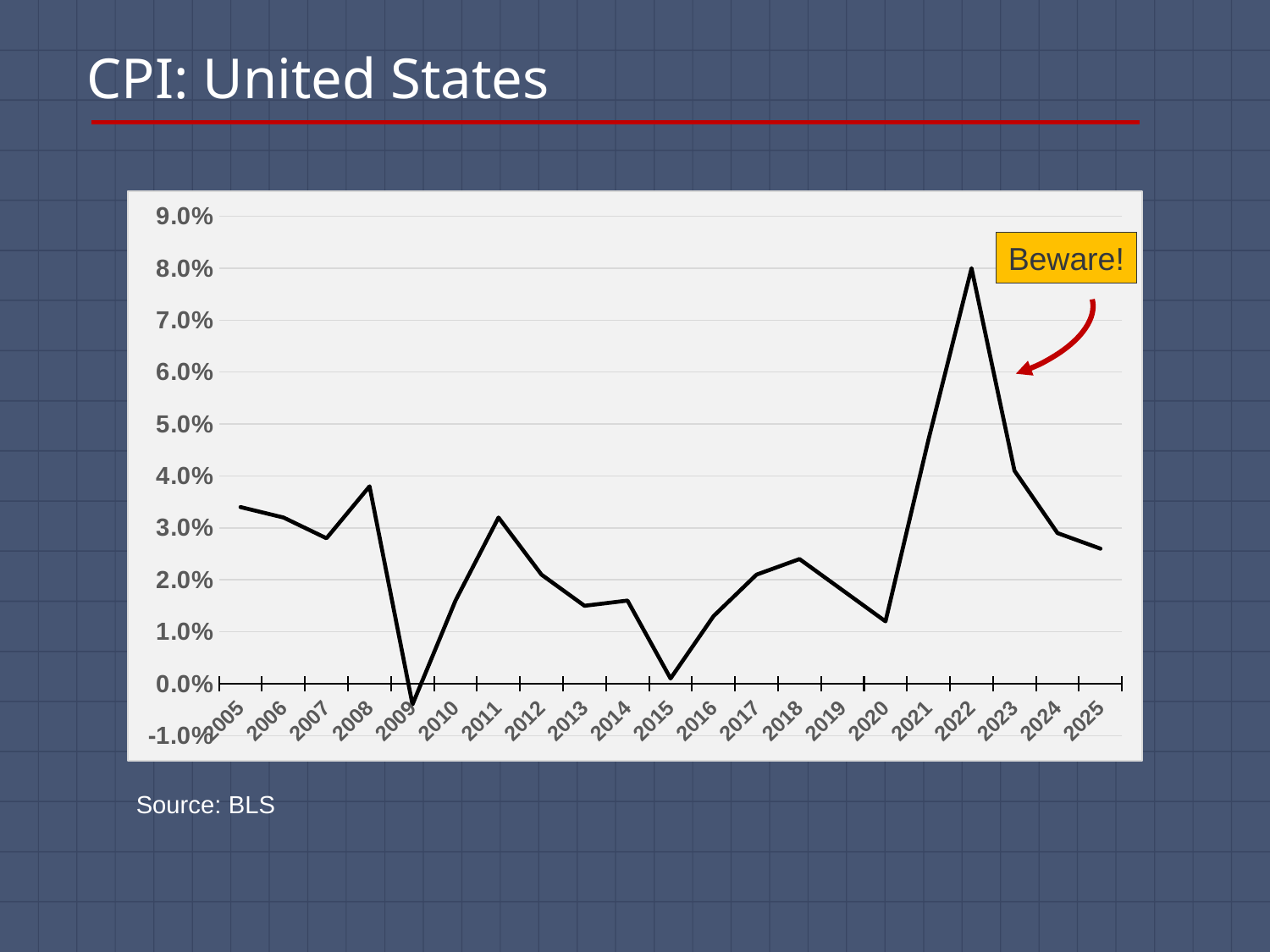
What is the title of the slide containing the chart? CPI: United States Is the value for 2022 greater or less than 7.0%? greater Which year has the lowest CPI value in the chart? 2009 Is the value for 2020 greater or less than 2.0%? less Which year has the larger CPI value, 2011 or 2012? 2011 Is the value for 2008 greater or less than 3.0%? greater How many years are plotted on the x axis of the chart? 21 Do the values rise or fall from 2022 to 2025? fall What does the yellow annotation box on the chart say? Beware! What kind of chart is shown on the slide? line chart Which year has the highest CPI value in the chart? 2022